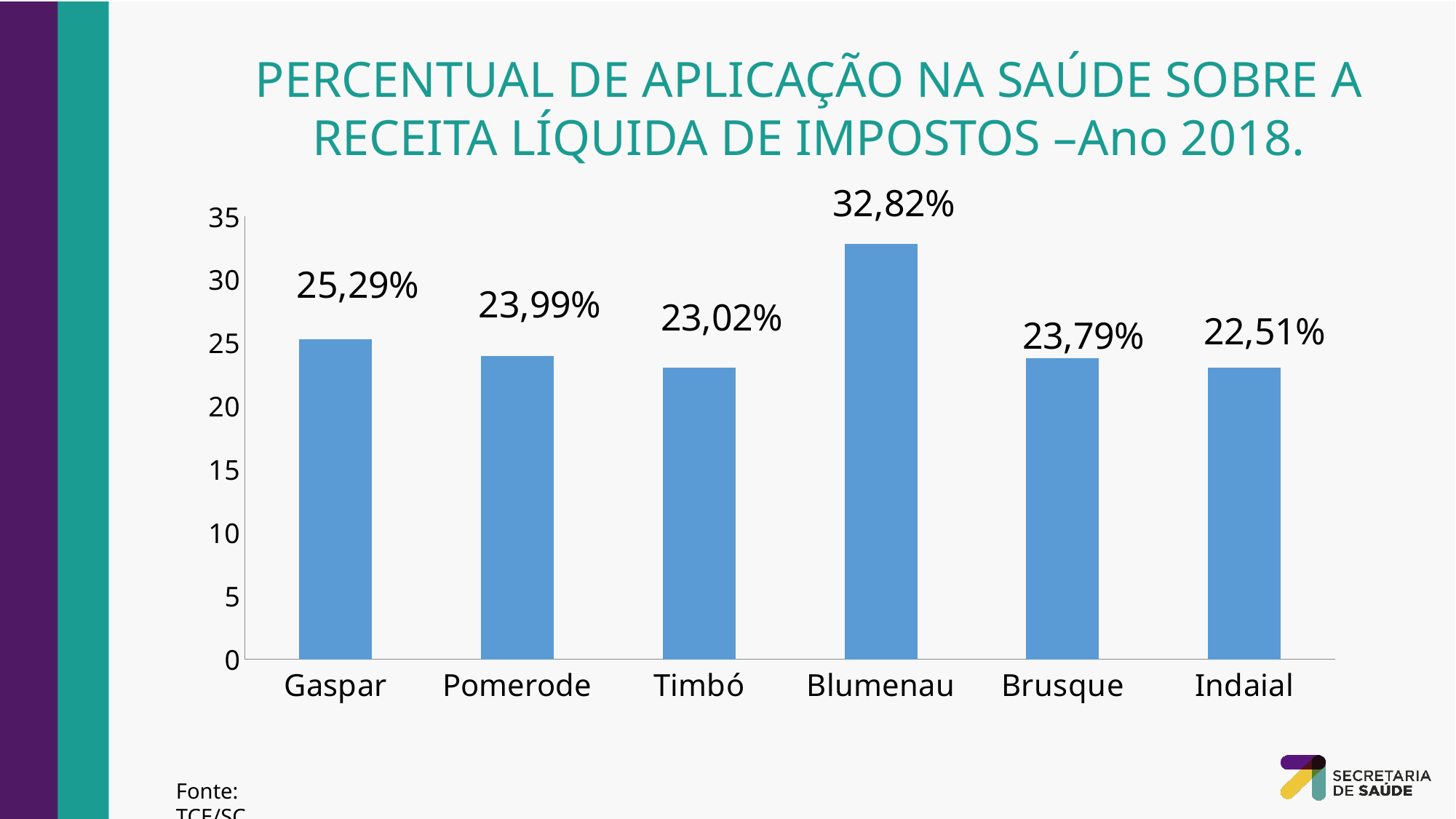
What is the value for Indaial? 22,51% How many municipalities are shown on the chart? 6 Which is larger, the value for Pomerode or the value for Timbó? Pomerode What is the value for Blumenau? 32,82% What is the value for Timbó? 23,02% What kind of chart is shown on the slide? Bar chart What is the difference between the values for Blumenau and Gaspar? 7,53 percentage points Which municipality has the highest percentage? Blumenau Is the value for Blumenau greater or less than 30? greater What is the value for Gaspar? 25,29% Which municipality has the lowest percentage? Indaial What is the difference between the values for Gaspar and Indaial? 2,78 percentage points